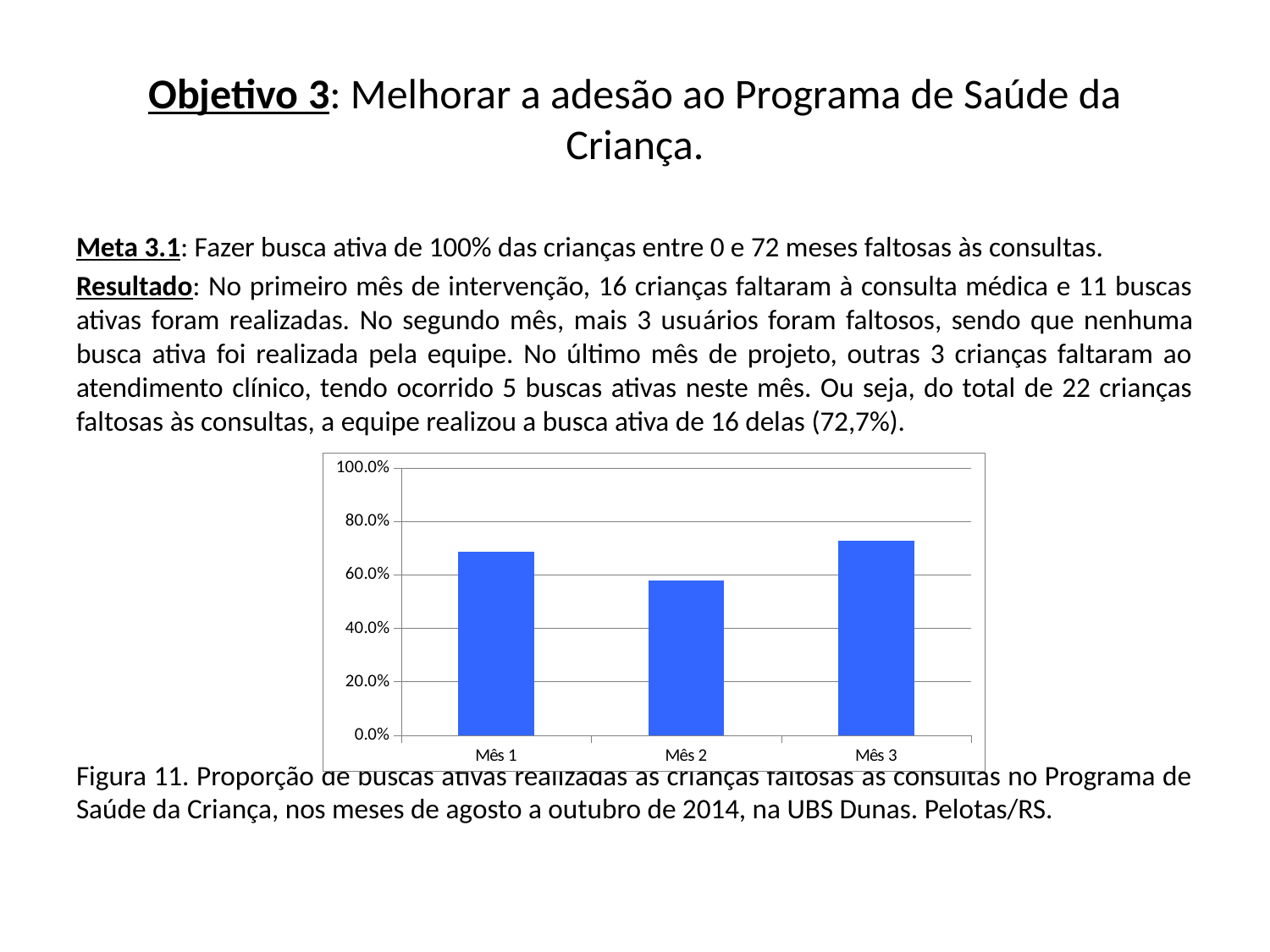
What kind of chart is shown on the slide? bar chart Is the value for Mês 1 greater or less than 60.0%? greater Which is larger in the chart, the value for Mês 1 or the value for Mês 2? Mês 1 Which month has the highest bar in the chart? Mês 3 Which month has the lowest bar in the chart? Mês 2 Do the values in the chart rise or fall from Mês 1 to Mês 2? fall Is the value for Mês 3 greater or less than 80.0%? less Is the value for Mês 2 greater or less than 40.0%? greater What colour are the bars in the chart? blue How many categories (months) are shown on the x axis of the chart? 3 What is the highest value shown on the y axis of the chart? 100.0%